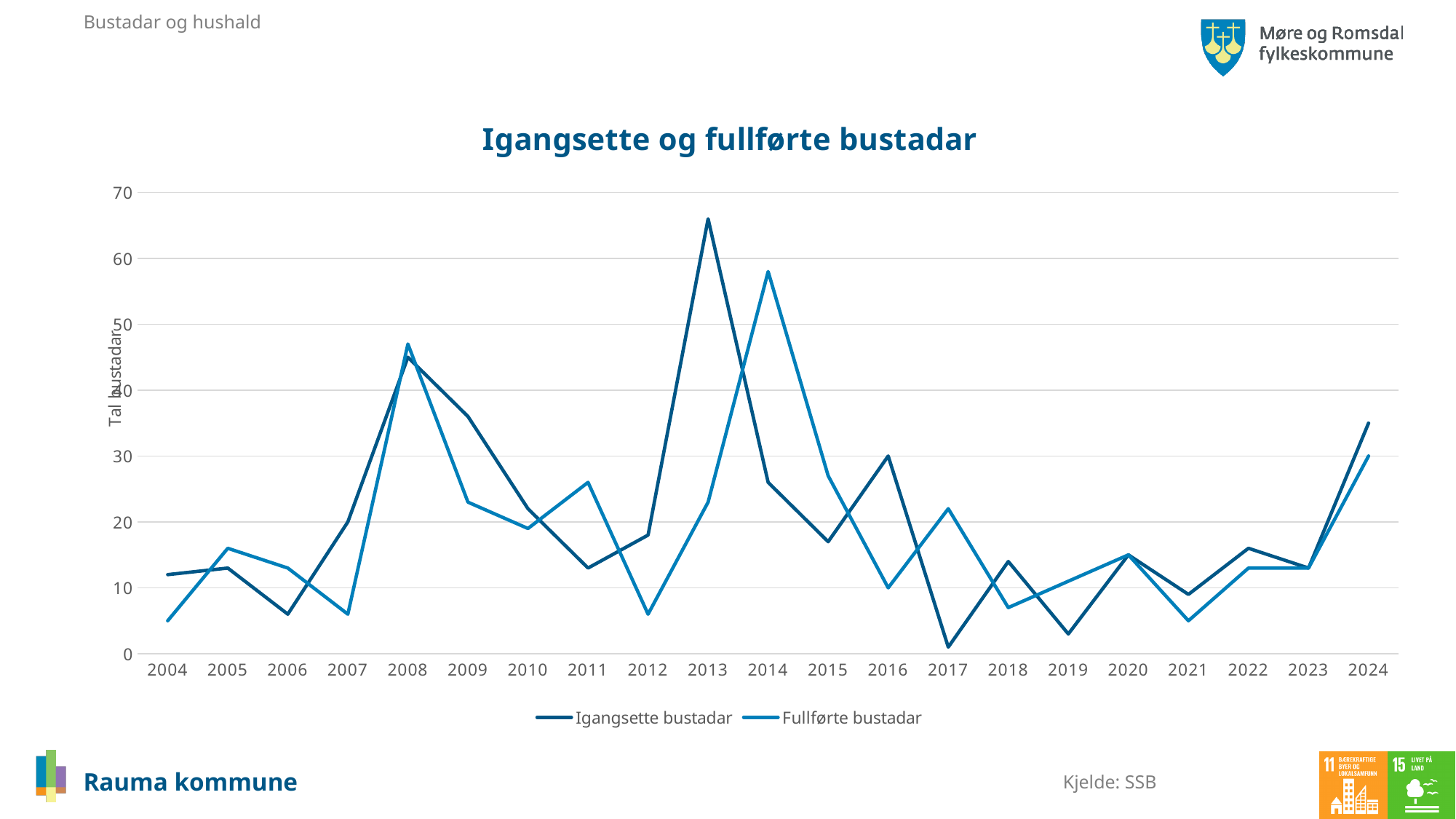
In which year is the value for Igangsette bustadar lowest? 2017 In which year is the value for Fullførte bustadar highest? 2014 Is the value for Igangsette bustadar in 2013 greater or less than 60? greater Is the value for Fullførte bustadar in 2014 greater or less than 50? greater In 2014, which series has the larger value, Igangsette bustadar or Fullførte bustadar? Fullførte bustadar In which year is the value for Igangsette bustadar highest? 2013 How many series does the legend list? 2 What kind of chart is shown on the slide? Line chart What is the title of the chart? Igangsette og fullførte bustadar How many years are shown on the x axis? 21 In 2007, which series has the larger value, Igangsette bustadar or Fullførte bustadar? Igangsette bustadar Is the value for Fullførte bustadar in 2012 greater or less than 10? less